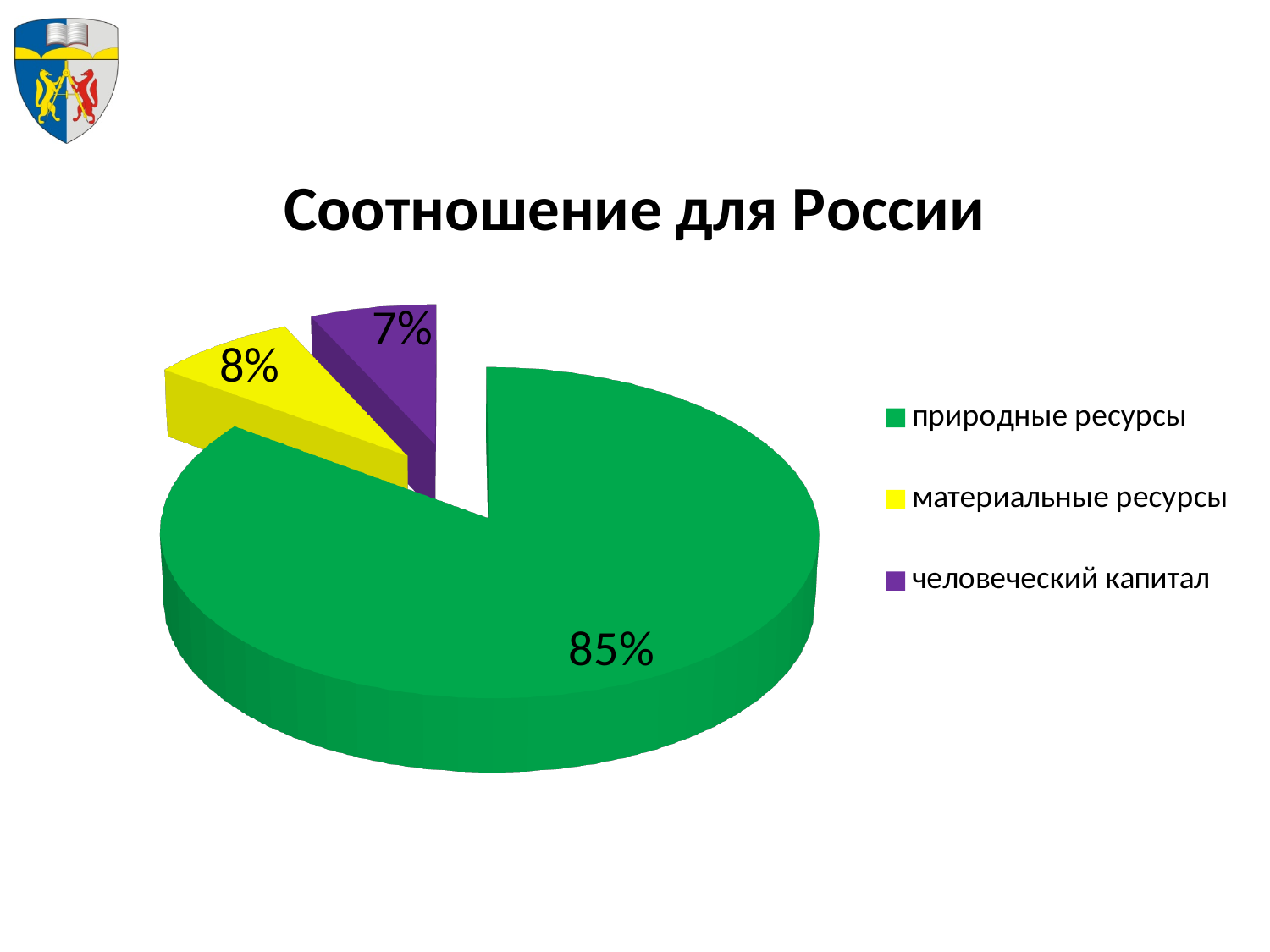
What is the difference in percentage points between природные ресурсы and материальные ресурсы? 77 Which category has the largest slice of the pie? природные ресурсы Which is larger, the slice for материальные ресурсы or the slice for человеческий капитал? материальные ресурсы What is the difference in percentage points between материальные ресурсы and человеческий капитал? 1 What colour is the slice for человеческий капитал? purple What kind of chart is shown on the slide? pie chart What share of the pie does человеческий капитал have? 7% What is the title of the chart? Соотношение для России What share of the pie does природные ресурсы have? 85% How many slices does the pie chart have? 3 What share of the pie does материальные ресурсы have? 8% Which category has the smallest slice of the pie? человеческий капитал